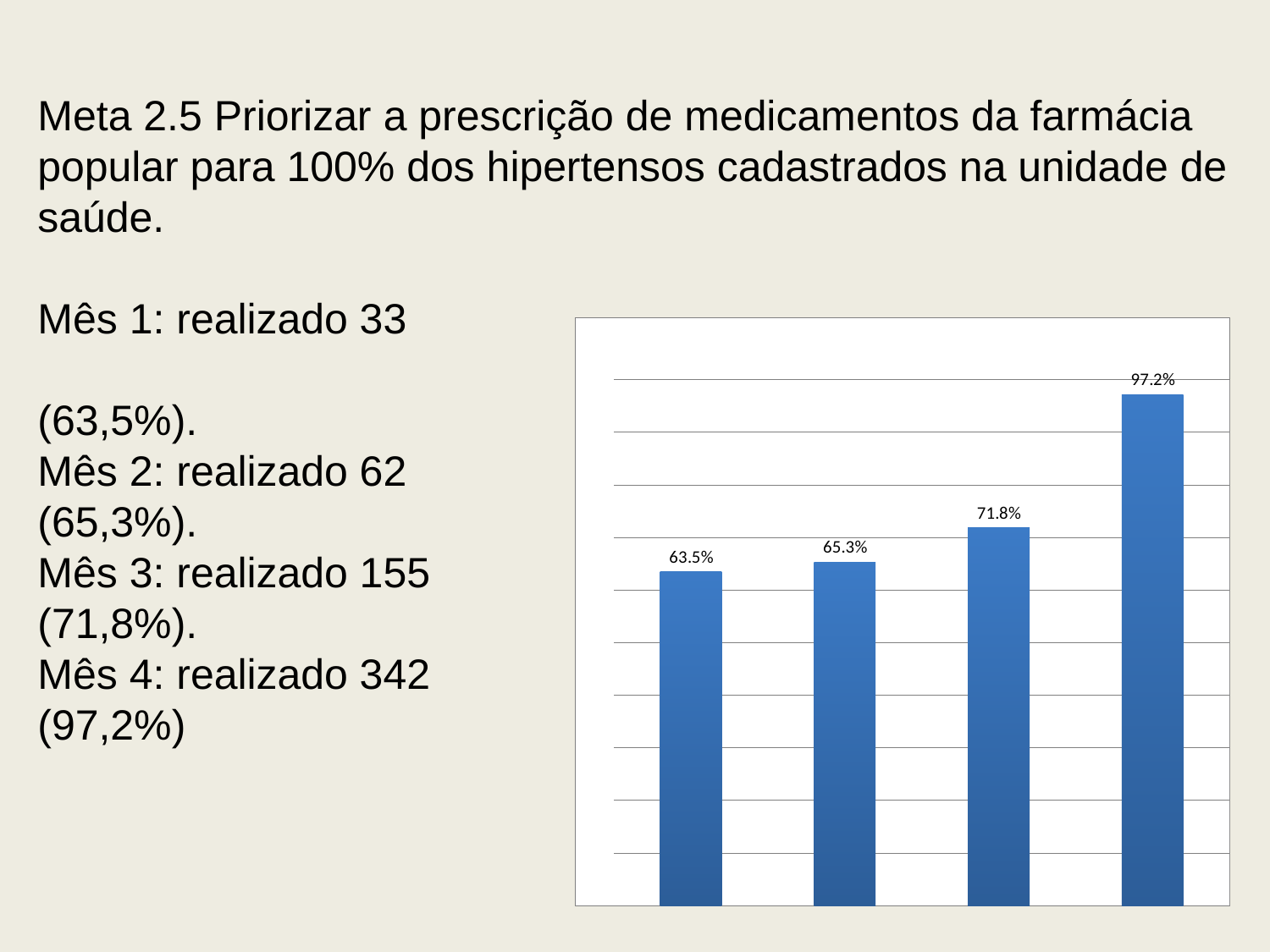
What is the data label on the fourth (rightmost) bar of the chart? 97.2% How many bars does the chart contain? 4 What is the data label on the first (leftmost) bar of the chart? 63.5% Which is larger in the chart, the third bar or the second bar? the third bar (71.8%) What is the data label on the third bar of the chart? 71.8% What is the difference between the third bar (71.8%) and the second bar (65.3%) in the chart? 6.5% What kind of chart is shown on the slide? bar chart What is the difference between the fourth bar (97.2%) and the first bar (63.5%) in the chart? 33.7% Which bar in the chart has the highest value? the fourth (rightmost) bar, 97.2% Which bar in the chart has the lowest value? the first (leftmost) bar, 63.5% What is the data label on the second bar of the chart? 65.3% Do the bar values rise or fall from left to right across the chart? rise